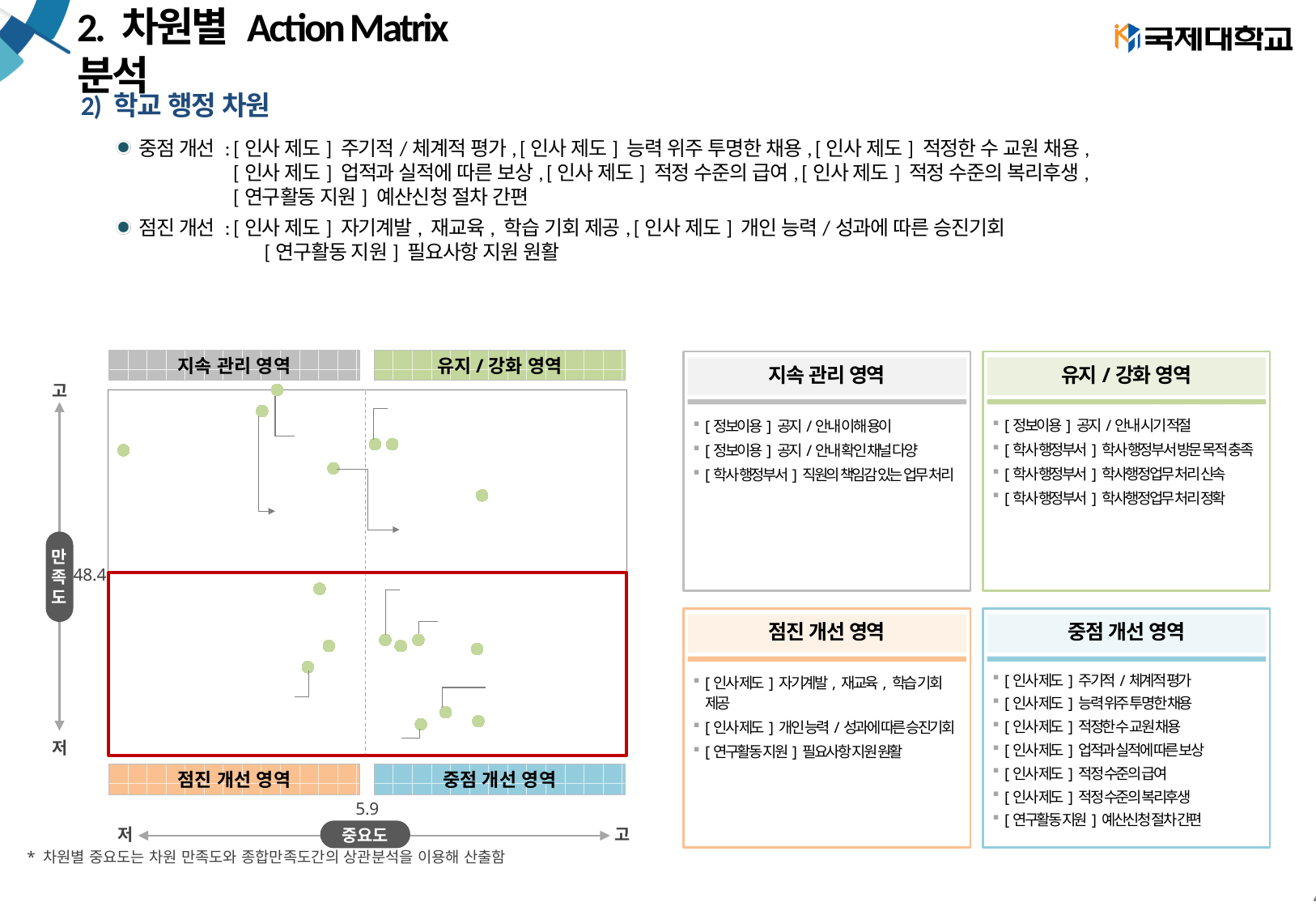
Which quadrant of the action matrix is in the lower-left (low importance, low satisfaction) position? 점진 개선 영역 What is the label of the horizontal axis of the action matrix chart? 중요도 How many points are plotted in the 지속 관리 영역 quadrant of the action matrix? 4 What is the label of the vertical axis of the action matrix chart? 만족도 How many points are plotted in the 유지 / 강화 영역 quadrant of the action matrix? 3 What kind of chart is shown on the left side of the slide? scatter chart Which quadrant of the action matrix is outlined with a red box? 점진 개선 영역 and 중점 개선 영역 (the whole lower half) What value is marked on the horizontal axis where the vertical dividing line of the action matrix is drawn? 5.9 Is the horizontal dividing line of the action matrix drawn at a satisfaction value greater or less than 50? less What value is marked on the vertical axis where the horizontal dividing line of the action matrix is drawn? 48.4 How many quadrants is the action matrix chart divided into? 4 Which quadrant of the action matrix contains the most points? 중점 개선 영역